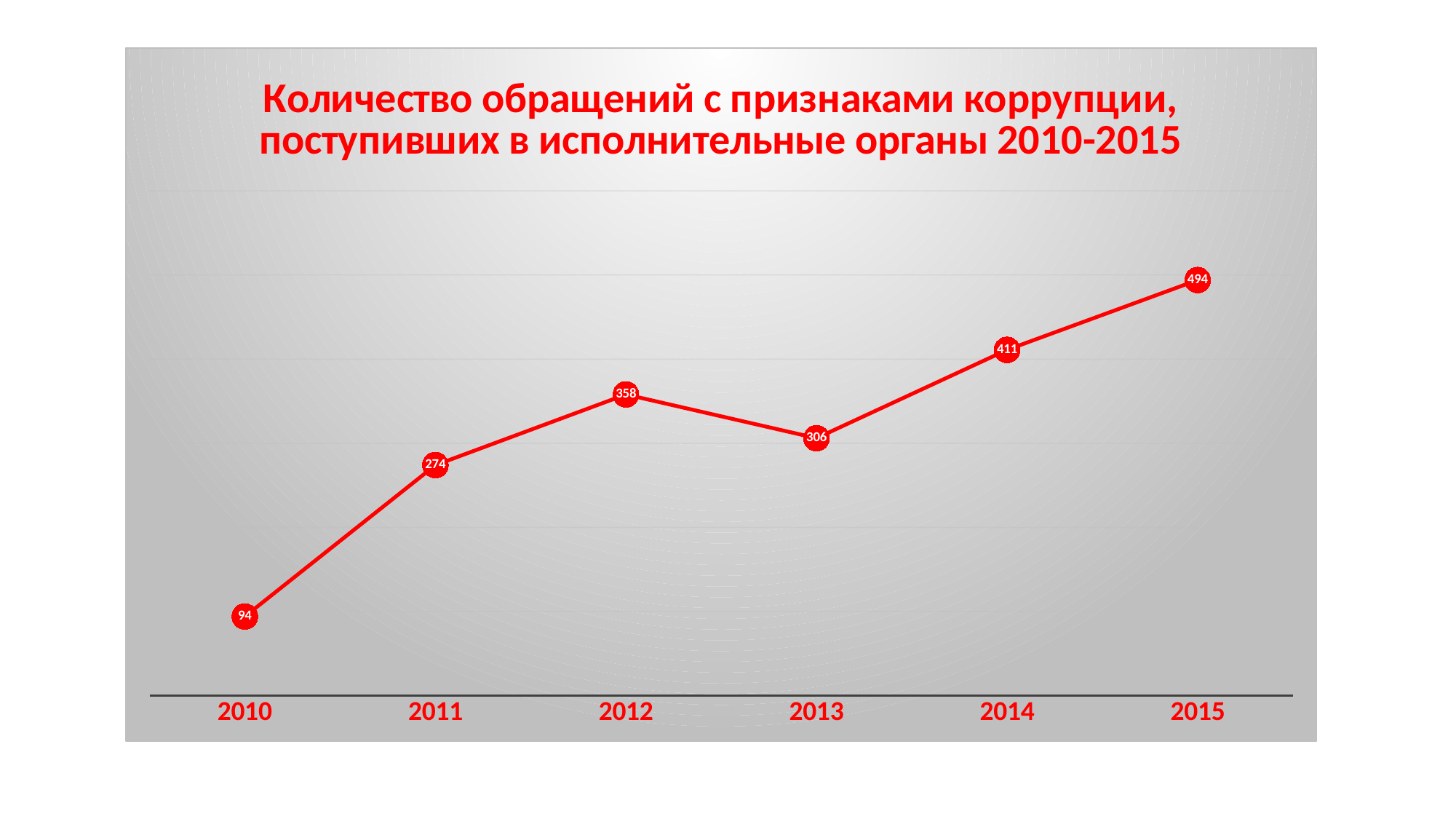
Does the value rise or fall from 2013 to 2015? rise What is the value for 2013? 306 What colour is the line on the chart? red How many years are plotted on the chart? 6 What kind of chart is shown on the slide? line chart Which year has the highest value? 2015 What is the value for 2015? 494 What is the difference between the values for 2012 and 2013? 52 What is the difference between the values for 2015 and 2014? 83 Which is larger, the value for 2012 or the value for 2013? 2012 What is the value for 2010? 94 Which year has the lowest value? 2010